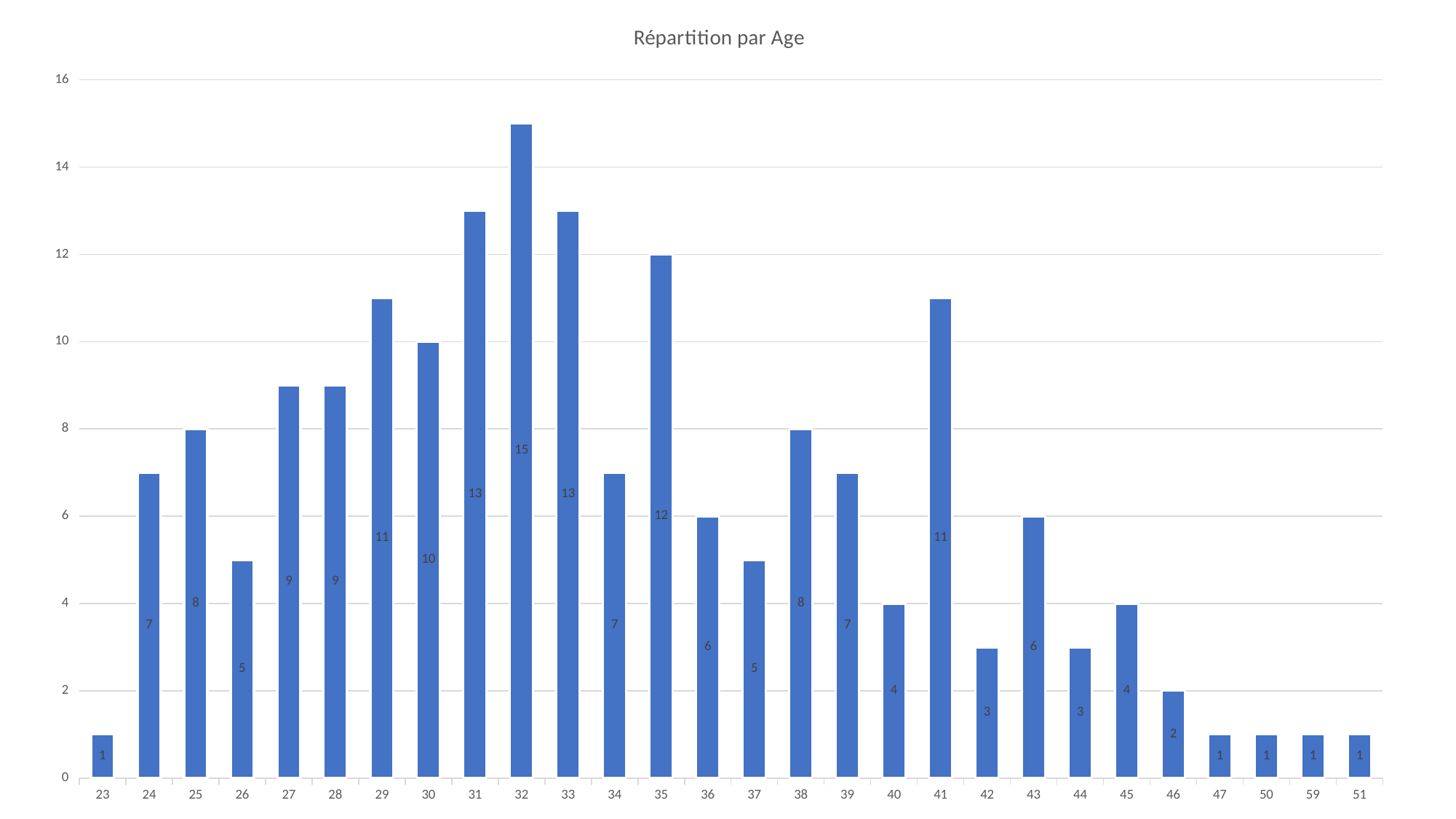
How many age categories are shown on the x axis? 28 What is the value for age 41? 11 What is the value for age 46? 2 Which has a larger value, age 31 or age 38? 31 Which has a larger value, age 43 or age 45? 43 What is the difference between the values for age 29 and age 40? 7 What is the value for age 32? 15 What is the value for age 26? 5 What is the difference between the values for age 32 and age 35? 3 What is the title of the chart? Répartition par Age What kind of chart is this? bar chart Which age has the highest value? 32